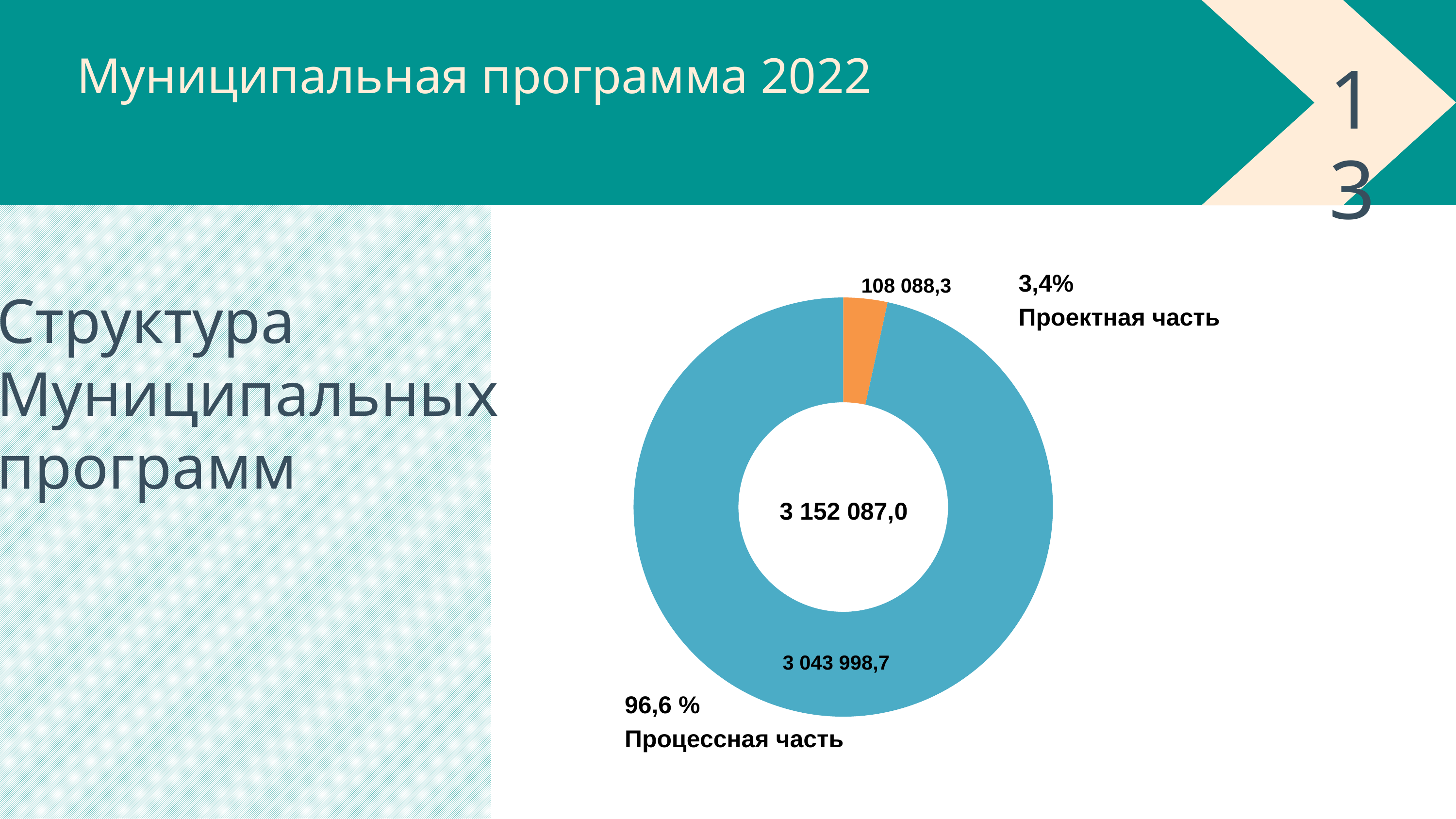
Which segment is the smallest? Проектная часть Which is larger, Проектная часть or Процессная часть? Процессная часть How many segments does the donut chart have? 2 What is the difference between the values for Процессная часть and Проектная часть? 2 935 910,4 What share of the chart does Проектная часть represent? 3,4% What share of the chart does Процессная часть represent? 96,6 % What is the value for Проектная часть? 108 088,3 What colour is the Проектная часть segment? Orange What kind of chart is shown on the slide? Donut (pie) chart Which segment is the largest? Процессная часть What is the value for Процессная часть? 3 043 998,7 What total value is shown in the centre of the donut chart? 3 152 087,0